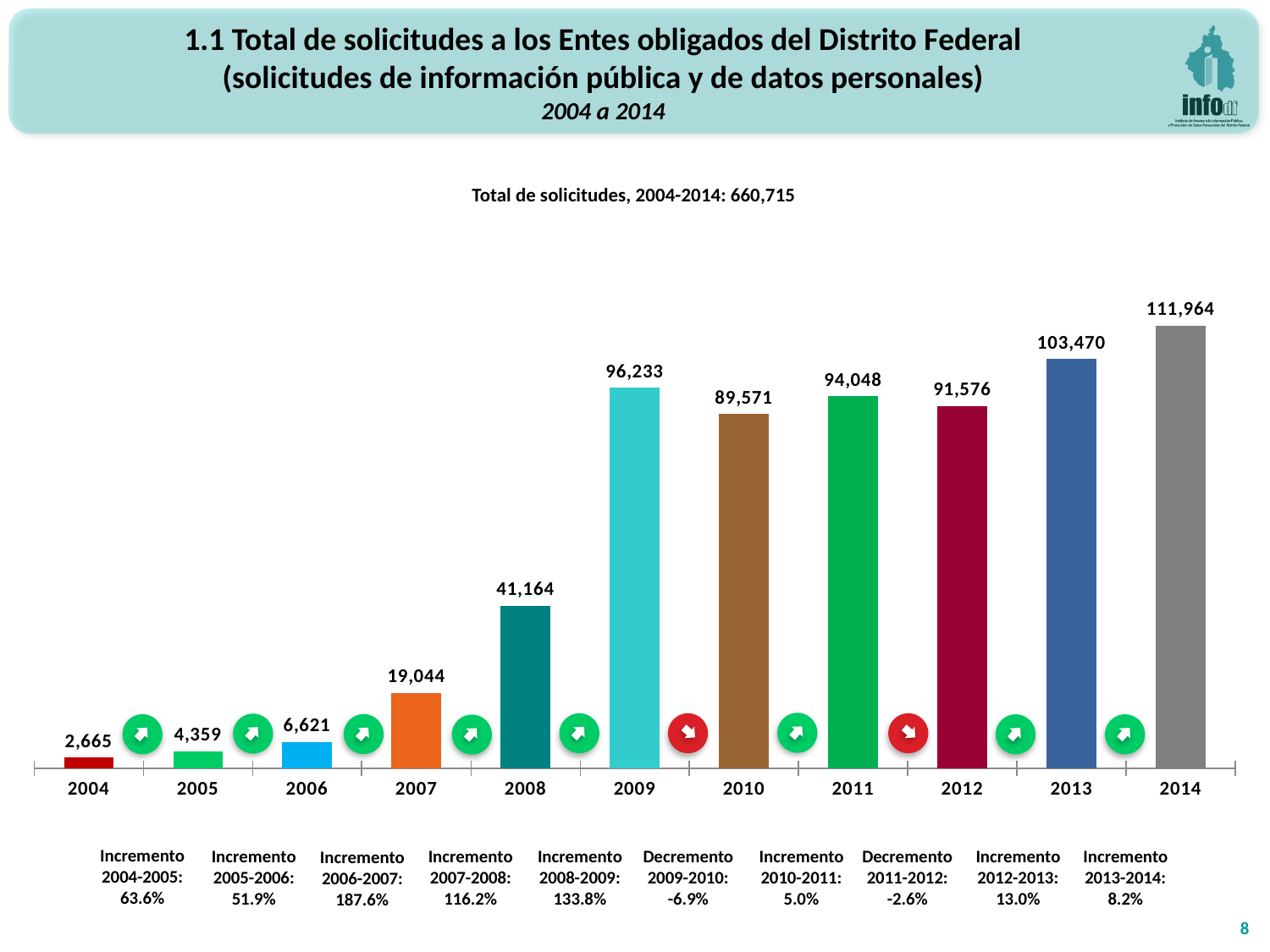
What is the value for 2009? 96,233 What is the difference between the values for 2008 and 2007? 22,120 What is the difference between the values for 2014 and 2013? 8,494 Which is larger, the value for 2010 or the value for 2011? 2011 What total of solicitudes for 2004-2014 is stated above the chart? 660,715 Do the values generally rise or fall from 2004 to 2014? rise What is the value for 2004? 2,665 Which year has the lowest value? 2004 What kind of chart is this? bar chart What is the value for 2012? 91,576 Which year has the highest value? 2014 How many years are shown on the x axis? 11